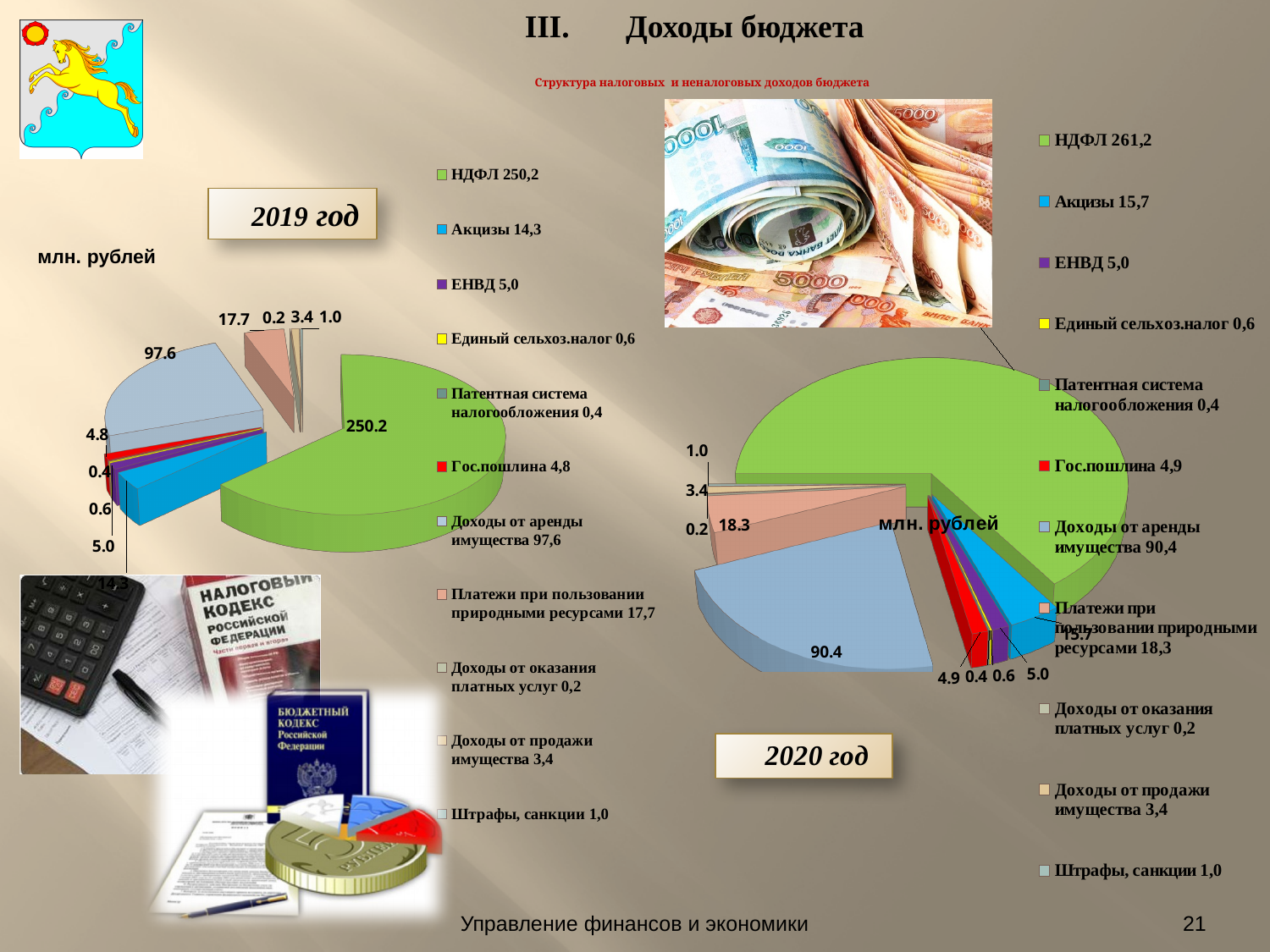
On the 2020 pie chart, what is the value for Доходы от аренды имущества? 90.4 What unit of measurement is indicated for the values on both pie charts? млн. рублей On the 2020 pie chart, what is the difference between Доходы от аренды имущества and Платежи при пользовании природными ресурсами? 72.1 On the 2019 pie chart, which is larger: Доходы от аренды имущества or Платежи при пользовании природными ресурсами? Доходы от аренды имущества On the 2020 pie chart, what is the value for Акцизы? 15.7 On the 2019 pie chart, what is the value for НДФЛ? 250.2 What type of chart is used to show the 2019 budget revenue structure? Pie chart On the 2019 pie chart, which category has the smallest value? Доходы от оказания платных услуг What is the difference between the НДФЛ value on the 2020 chart and the НДФЛ value on the 2019 chart? 11.0 On the 2019 pie chart, what is the value for Платежи при пользовании природными ресурсами? 17.7 On the 2020 pie chart, which category has the largest value? НДФЛ How many categories does the legend of the 2020 pie chart list? 11